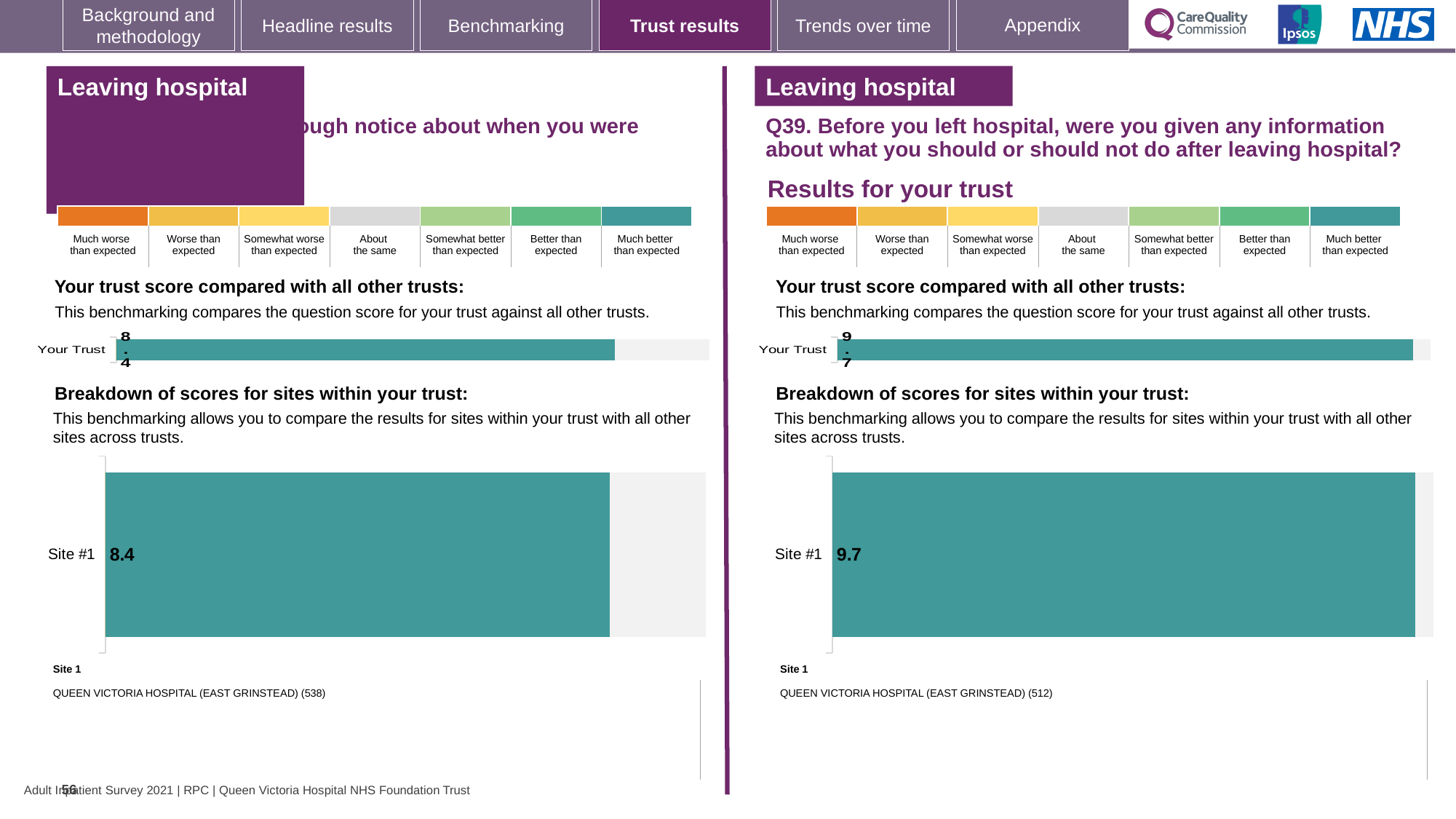
Which is larger: the Site #1 score on the left-hand chart or the Site #1 score on the right-hand Q39 chart? The right-hand Q39 chart (9.7) What kind of chart is used to show the Site #1 score on the right-hand side of the slide? Bar chart Which hospital is listed as Site 1 beneath the right-hand Q39 breakdown chart? Queen Victoria Hospital (East Grinstead) What is the difference between the Your Trust score on the right-hand Q39 chart and the Your Trust score on the left-hand chart? 1.3 On the left-hand chart, what is the score shown for Site #1? 8.4 On the left-hand chart, what is the score shown for Your Trust? 8.4 Which is larger: the Your Trust score on the left-hand chart or the Your Trust score on the right-hand Q39 chart? The right-hand Q39 chart (9.7) On the left-hand breakdown chart, how many sites are plotted? 1 On the right-hand Q39 breakdown chart, how many sites are plotted? 1 On the right-hand chart for Q39, what is the score shown for Your Trust? 9.7 On the right-hand chart for Q39, what is the score shown for Site #1? 9.7 What colour are the bars in the Site #1 charts on the slide? Teal